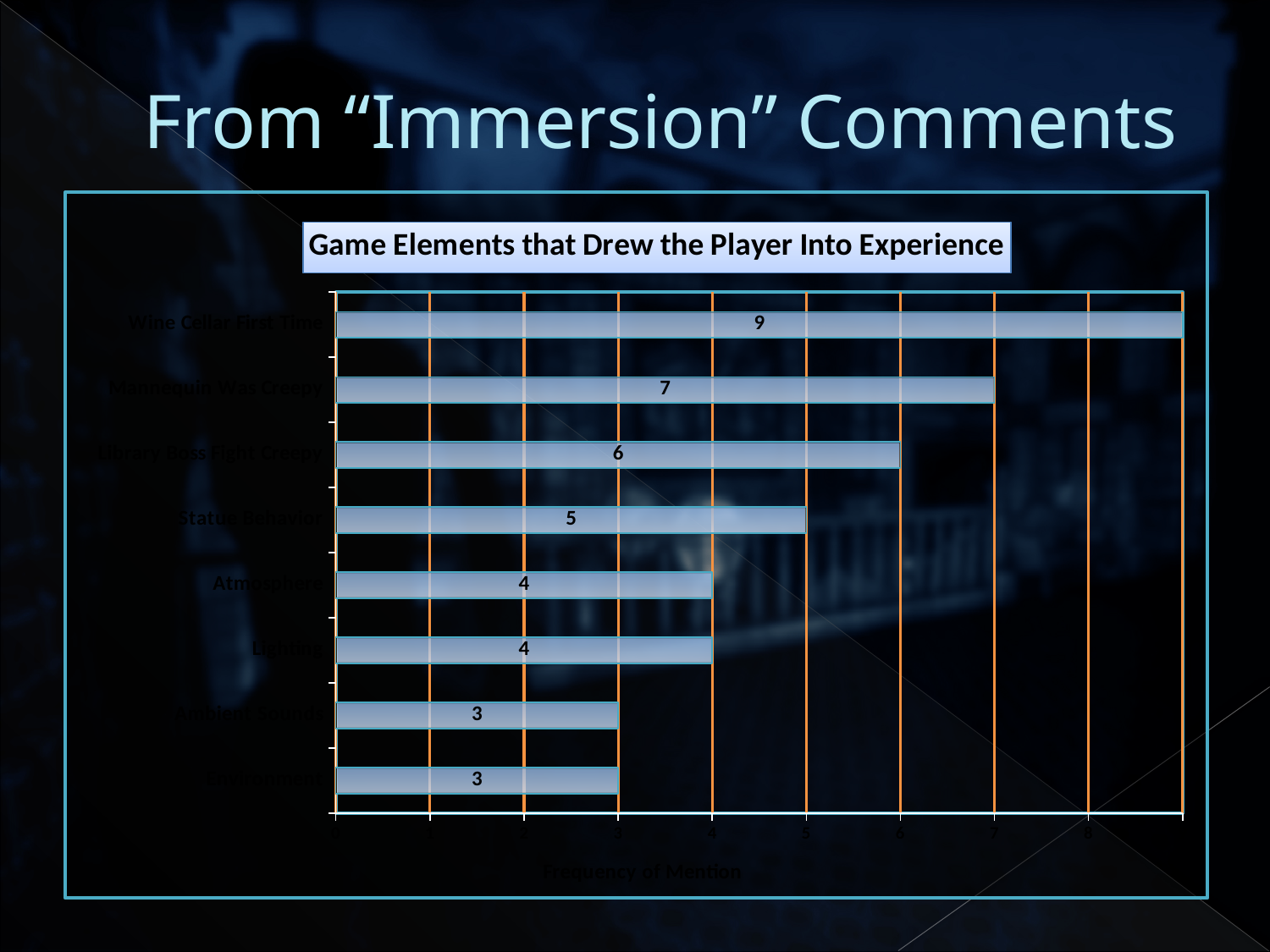
What is the title of the chart? Game Elements that Drew the Player Into Experience What is the difference between the values for Wine Cellar First Time and Mannequin Was Creepy? 2 What is the value for Mannequin Was Creepy? 7 How many categories are plotted in the chart? 8 What kind of chart is shown on the slide? bar chart Which category has the highest value? Wine Cellar First Time What is the value for Wine Cellar First Time? 9 What is the value for Statue Behavior? 5 Which is larger, the value for Library Boss Fight Creepy or the value for Statue Behavior? Library Boss Fight Creepy What is the value for Atmosphere? 4 What is the difference between the values for Statue Behavior and Ambient Sounds? 2 What is the label of the horizontal axis? Frequency of Mention